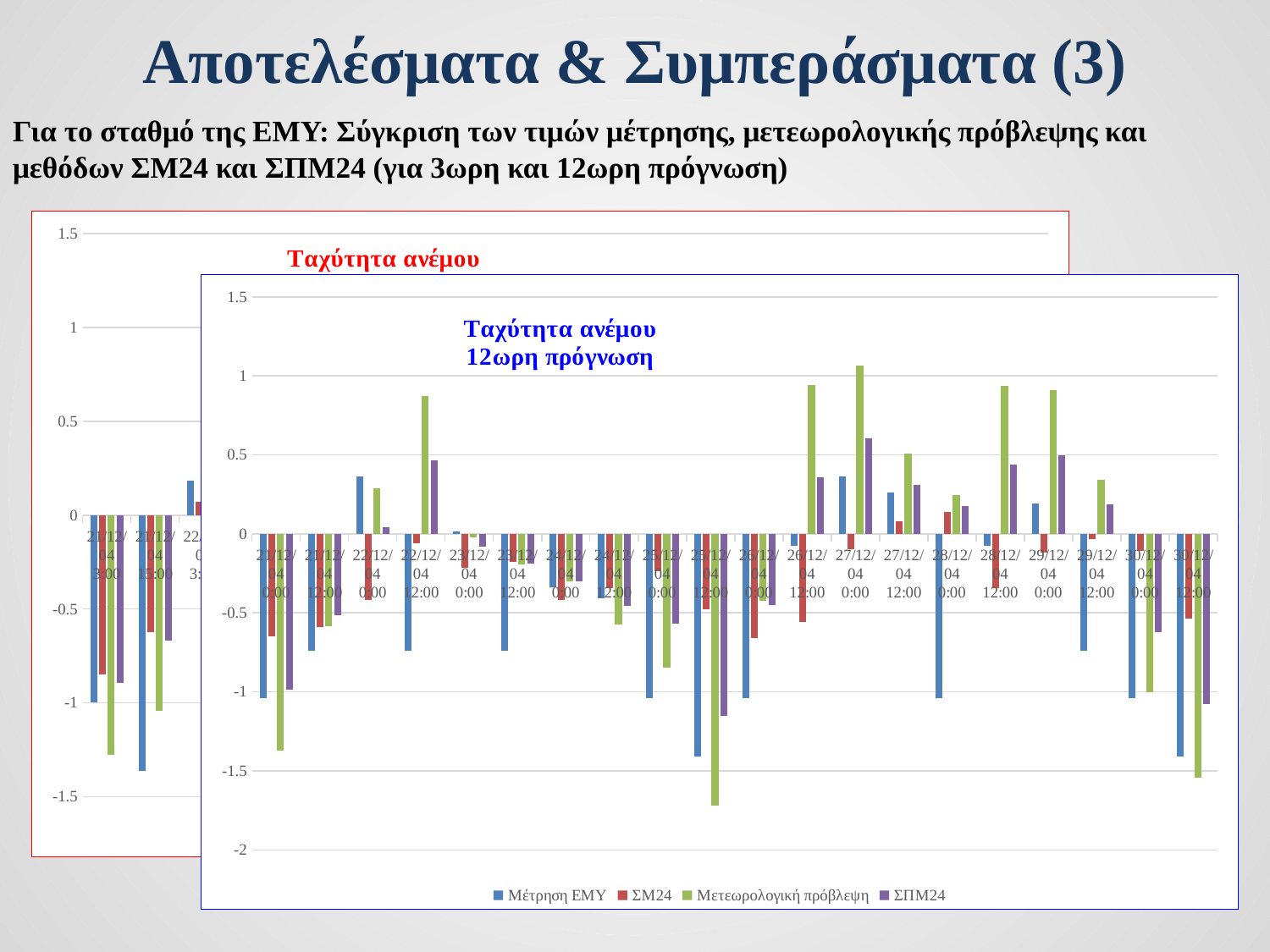
In the front chart 'Ταχύτητα ανέμου 12ωρη πρόγνωση', at which category does the Μετεωρολογική πρόβλεψη series reach its highest value? 27/12/04 0:00 In the front chart 'Ταχύτητα ανέμου 12ωρη πρόγνωση', is the Μέτρηση ΕΜΥ value for 22/12/04 0:00 greater or less than 0.5? less What is the title of the chart partially hidden behind the front chart? Ταχύτητα ανέμου In the front chart titled 'Ταχύτητα ανέμου 12ωρη πρόγνωση', what kind of chart is shown? Bar chart In the front chart 'Ταχύτητα ανέμου 12ωρη πρόγνωση', at which category does the Μετεωρολογική πρόβλεψη series reach its lowest value? 25/12/04 12:00 In the front chart 'Ταχύτητα ανέμου 12ωρη πρόγνωση', which colour represents the ΣΜ24 series in the legend? Red In the front chart 'Ταχύτητα ανέμου 12ωρη πρόγνωση', is the Μετεωρολογική πρόβλεψη value for 25/12/04 12:00 greater or less than -1.5? less In the front chart 'Ταχύτητα ανέμου 12ωρη πρόγνωση', how many series does the legend list? 4 In the front chart 'Ταχύτητα ανέμου 12ωρη πρόγνωση', how many date/time categories are shown on the x axis? 20 In the front chart 'Ταχύτητα ανέμου 12ωρη πρόγνωση', at 27/12/04 0:00, which is larger: the Μετεωρολογική πρόβλεψη value or the ΣΠΜ24 value? Μετεωρολογική πρόβλεψη In the front chart 'Ταχύτητα ανέμου 12ωρη πρόγνωση', is the Μετεωρολογική πρόβλεψη value for 27/12/04 0:00 greater or less than 1? greater